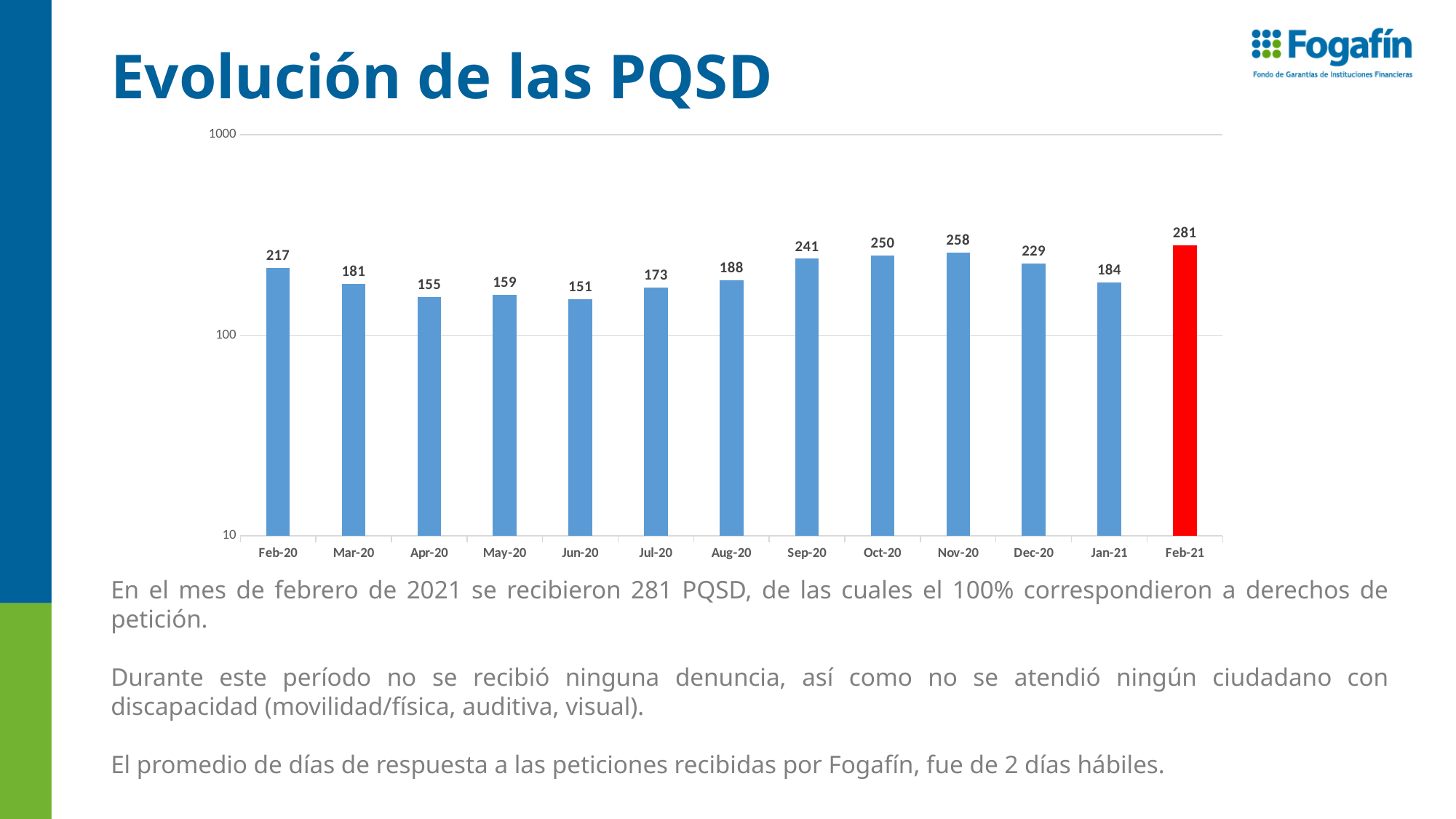
Which bar is coloured red instead of blue? Feb-21 Which month has the highest value? Feb-21 What is the value for Feb-21? 281 What is the difference between the values for Feb-21 and Jan-21? 97 Which month has the lowest value? Jun-20 What is the difference between the values for Oct-20 and Sep-20? 9 What is the value for Nov-20? 258 What kind of chart is shown on the slide? bar chart Is the value for Apr-20 greater or less than 100? greater How many months are shown on the x axis? 13 What is the value for Jun-20? 151 Which is larger, the value for Feb-20 or the value for Dec-20? Dec-20